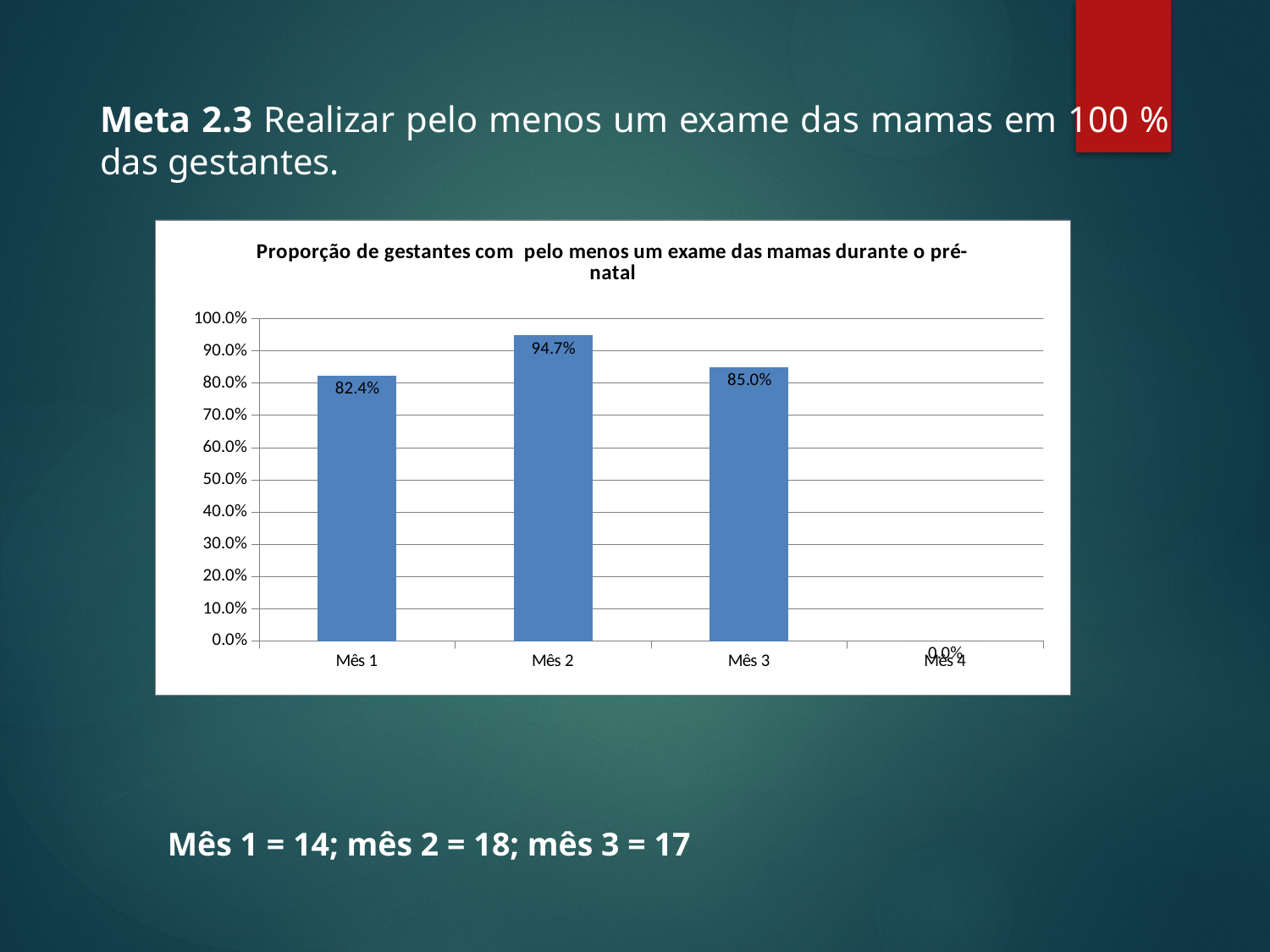
Which is larger, the value for Mês 3 or the value for Mês 1? Mês 3 Which month has the highest value? Mês 2 What is the value for Mês 2? 94.7% What is the value for Mês 4? 0.0% What kind of chart is shown? bar chart How many months are shown on the x axis? 4 What is the difference between the values for Mês 2 and Mês 1? 12.3% What is the value for Mês 1? 82.4% What is the value for Mês 3? 85.0% Which month has the lowest value? Mês 4 What is the title of the chart? Proporção de gestantes com pelo menos um exame das mamas durante o pré-natal Is the value for Mês 2 greater or less than 90.0%? greater